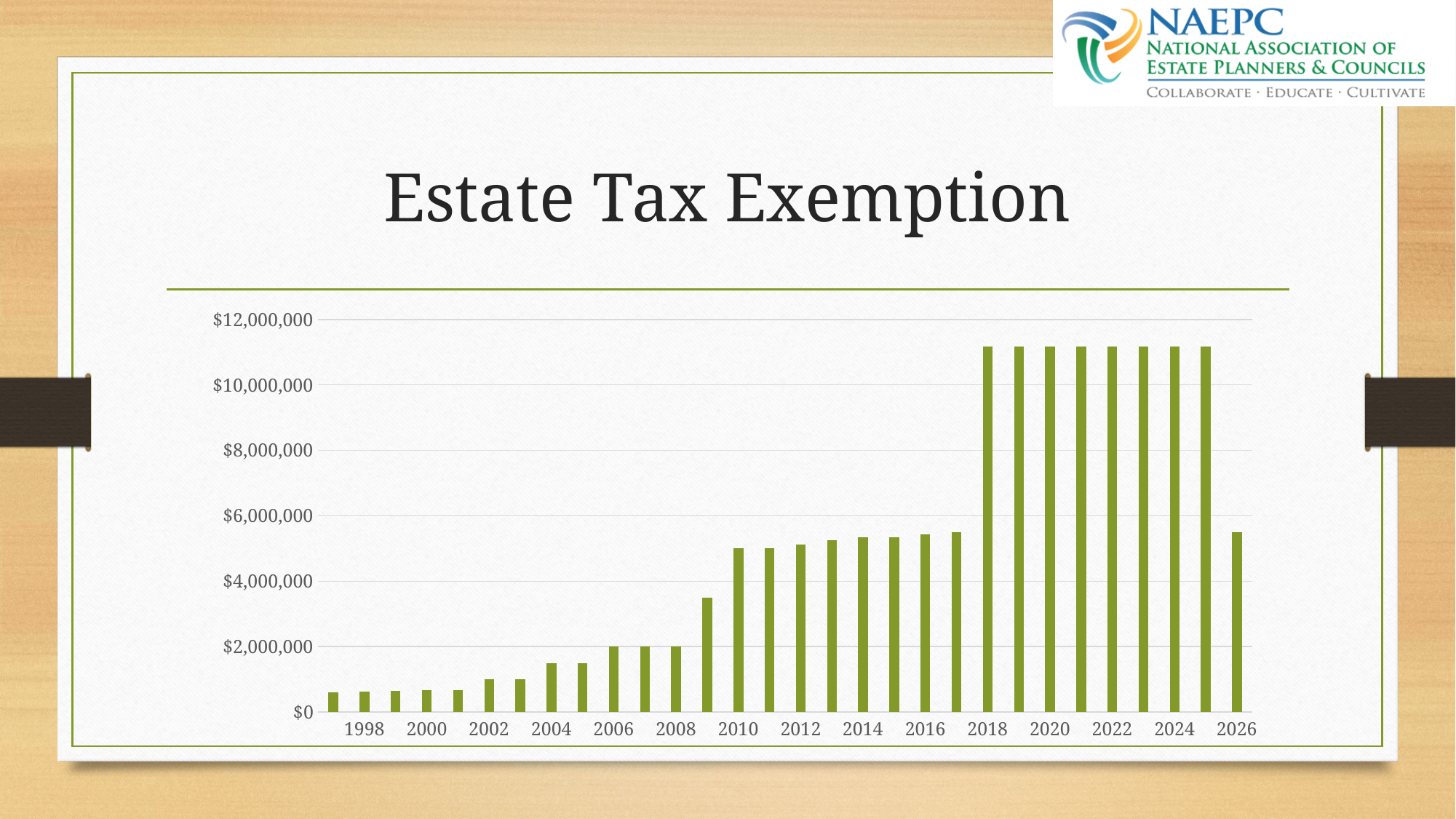
Which year has the larger value, 2009 or 2017? 2017 Is the value for 2010 greater or less than $4,000,000? greater Which year has the larger value, 2025 or 2026? 2025 What colour are the bars in the chart? green How many bars are plotted in the chart? 30 Is the value for 2009 greater or less than $4,000,000? less What kind of chart is shown on the slide? bar chart Is the value for 2018 greater or less than $10,000,000? greater What is the title of the chart? Estate Tax Exemption Do the values rise or fall from 1997 to 2017? rise